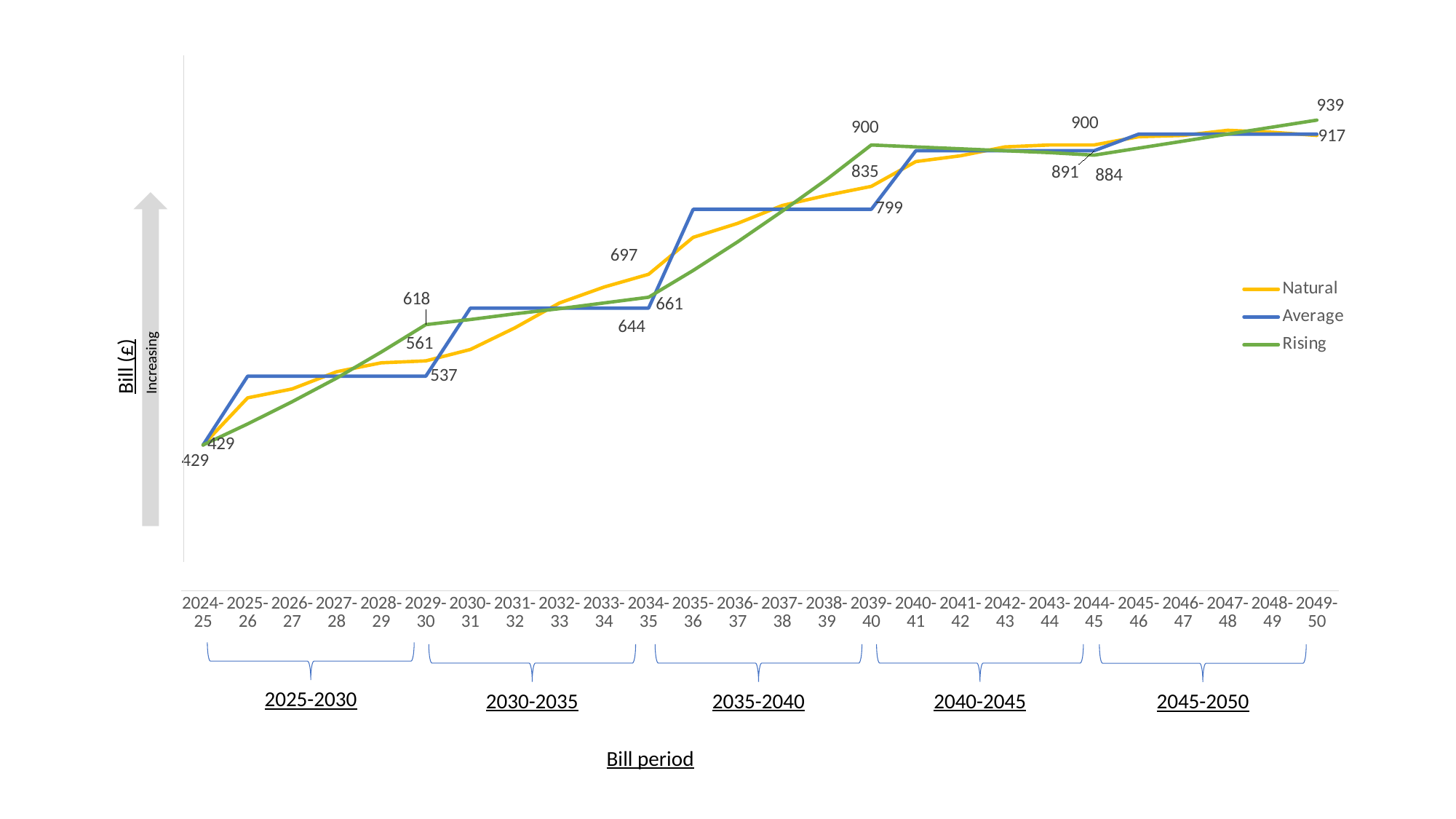
How many series does the legend list? 3 What is the value of the Natural series for the 2034-35 bill period? 697 For the 2029-30 bill period, which is higher: the Rising series or the Average series? Rising Do the values generally rise or fall across the bill periods? rise What kind of chart is shown on the slide? line chart What is the value of the Average series for the 2039-40 bill period? 799 What is the difference between the Rising and Average values for the 2039-40 bill period? 101 How many bill periods are shown on the x axis? 26 What is the title of the x axis? Bill period What is the value of the Rising series for the 2039-40 bill period? 900 What is the value shown for the 2024-25 bill period? 429 What is the value of the Rising series for the 2049-50 bill period? 939